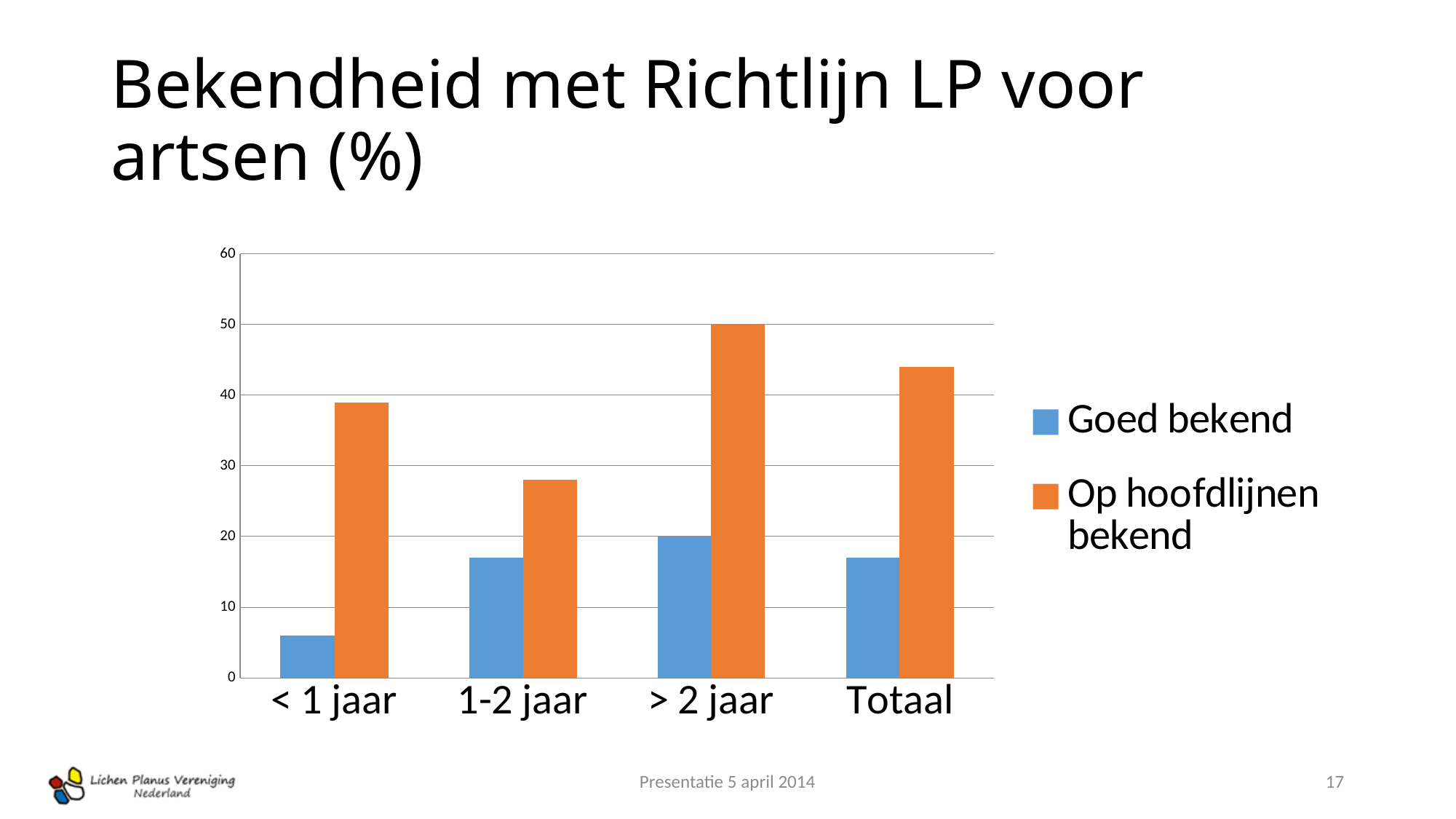
Is the value for 'Op hoofdlijnen bekend' in the 'Totaal' category greater or less than 40? greater In the '1-2 jaar' category, which series has the larger value: 'Goed bekend' or 'Op hoofdlijnen bekend'? Op hoofdlijnen bekend What is the value for 'Goed bekend' in the '> 2 jaar' category? 20 What is the value for 'Op hoofdlijnen bekend' in the '> 2 jaar' category? 50 How many series does the legend list? 2 Which category has the lowest value for 'Op hoofdlijnen bekend'? 1-2 jaar What is the title of the slide containing the chart? Bekendheid met Richtlijn LP voor artsen (%) What kind of chart is shown on the slide? bar chart Which category has the lowest value for 'Goed bekend'? < 1 jaar Which category has the highest value for 'Op hoofdlijnen bekend'? > 2 jaar How many categories are shown on the x axis? 4 Is the value for 'Goed bekend' in the '< 1 jaar' category greater or less than 10? less